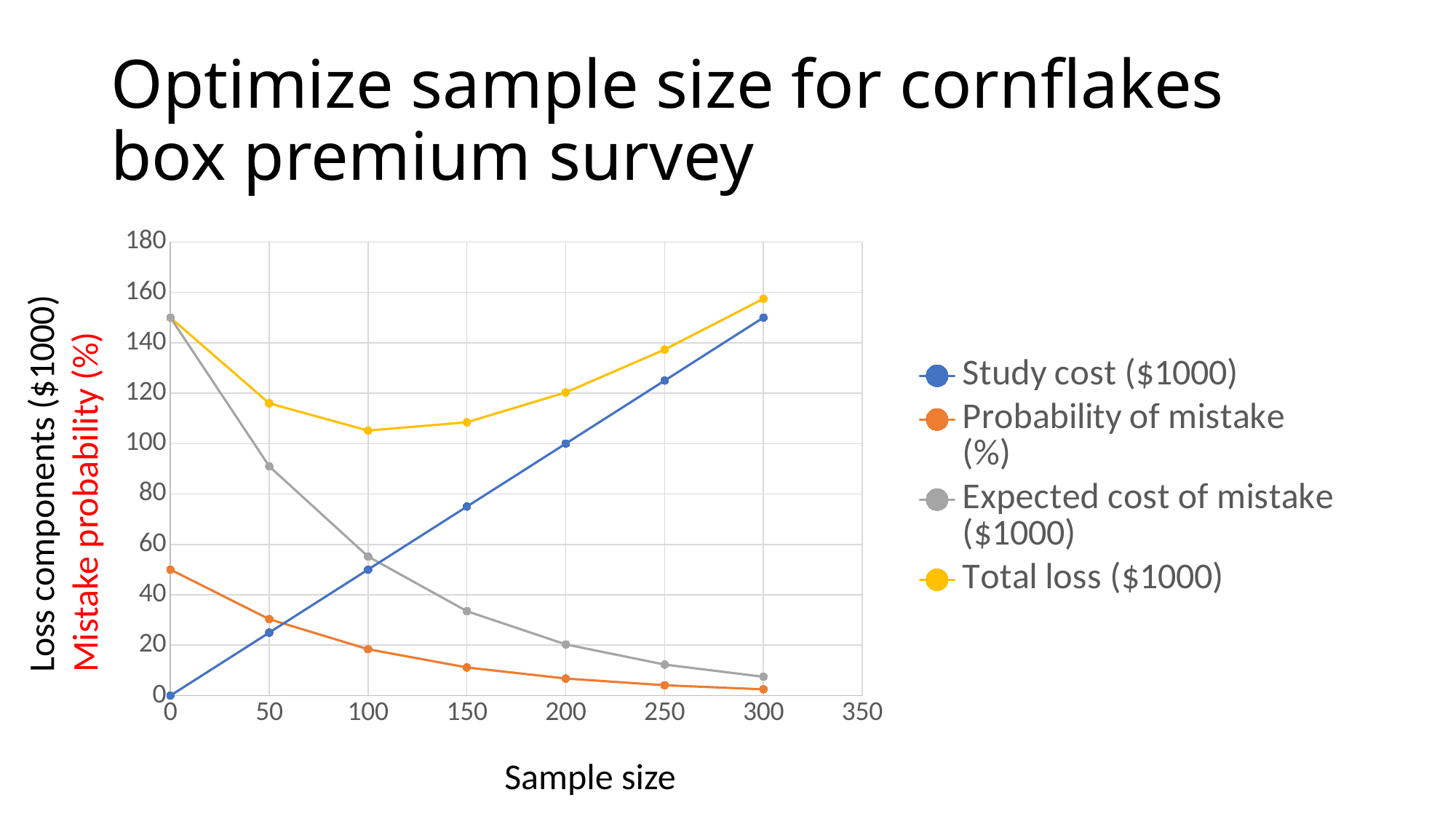
What is the Study cost ($1000) at sample size 200? 100 How many series does the legend list? 4 At which sample size is the Total loss ($1000) lowest? 100 What kind of chart is shown on the slide? line chart Is the Total loss ($1000) at sample size 300 greater or less than 140? greater What is the title of the x axis? Sample size At sample size 150, which is larger: Study cost ($1000) or Expected cost of mistake ($1000)? Study cost ($1000) How many data points are plotted for the Total loss ($1000) series? 7 Is the Expected cost of mistake ($1000) at sample size 50 greater or less than 80? greater Is the Total loss ($1000) at sample size 100 greater or less than 120? less Does the Probability of mistake (%) series rise or fall as sample size increases? falls Does the Study cost ($1000) series rise or fall as sample size increases? rises